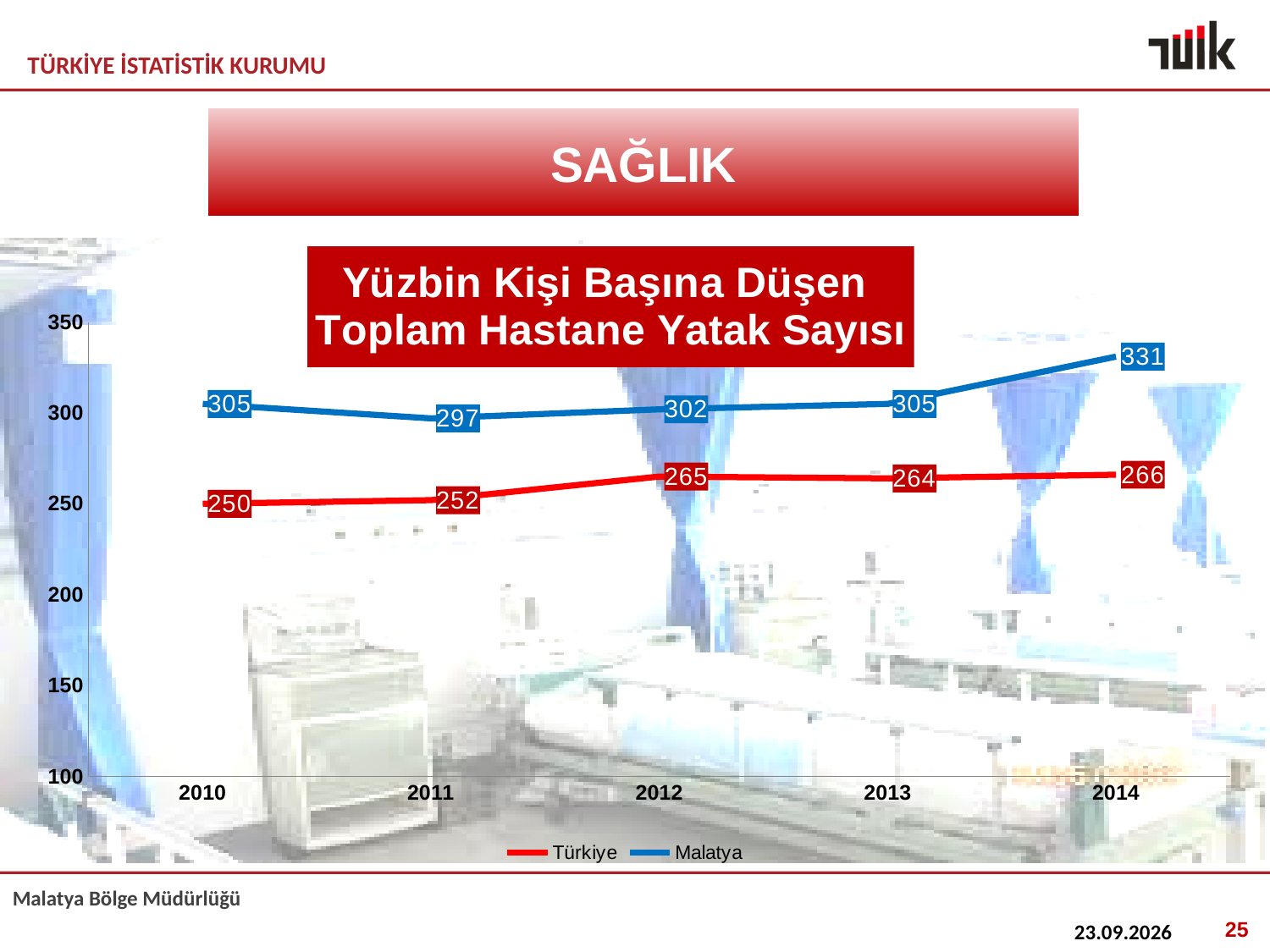
What kind of chart is shown on the slide? Line chart How many years are shown on the x axis? 5 Which is larger in 2012, the Türkiye value or the Malatya value? Malatya What is the value for Türkiye in 2013? 264 What is the title of the chart? Yüzbin Kişi Başına Düşen Toplam Hastane Yatak Sayısı What is the value for Türkiye in 2010? 250 What is the value for Malatya in 2014? 331 In which year is the Türkiye value lowest? 2010 In which year is the Malatya value highest? 2014 How many series does the legend list? 2 What is the value for Malatya in 2011? 297 What is the difference between the Malatya and Türkiye values in 2014? 65